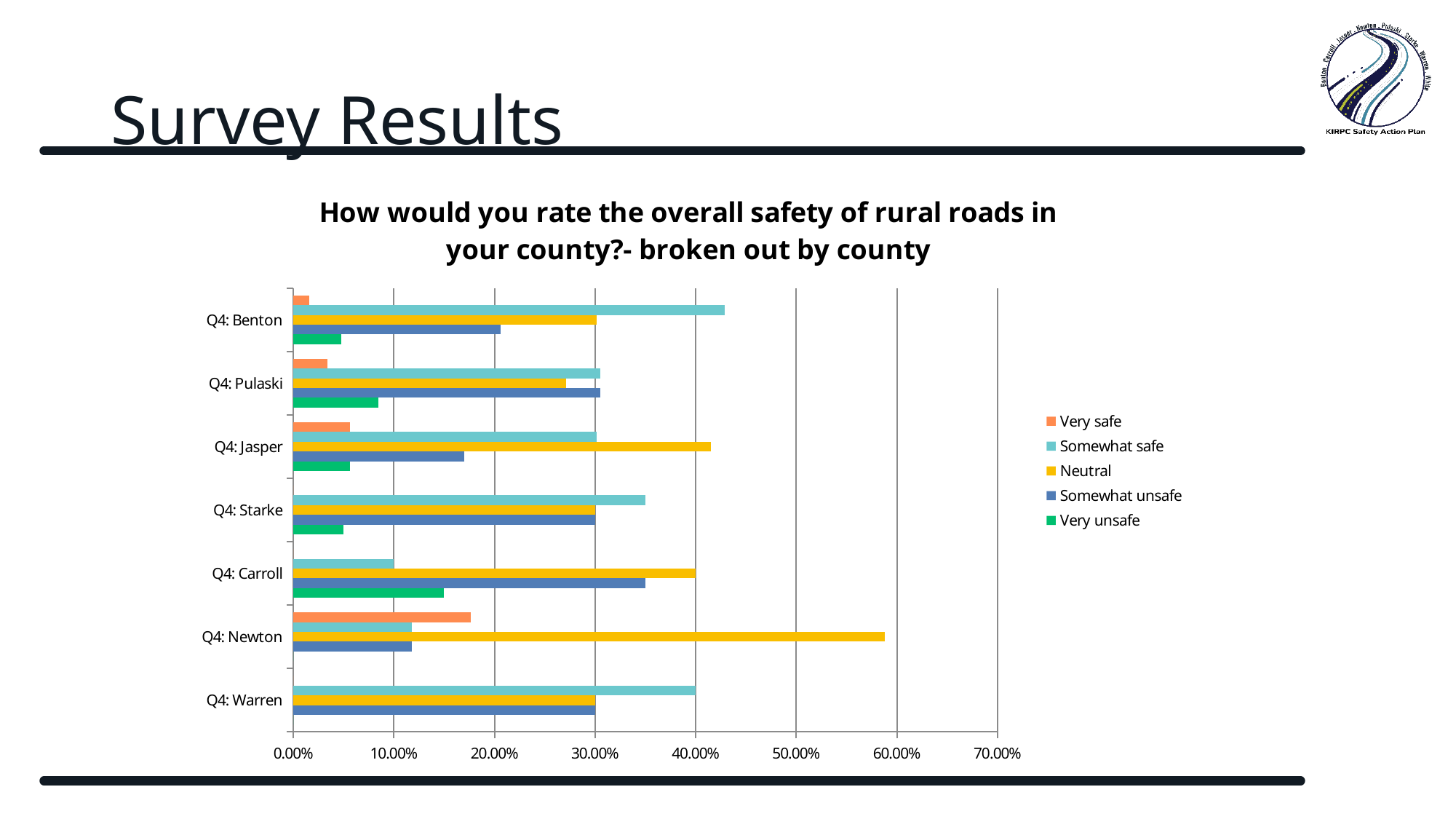
Which county has the highest Very safe value? Q4: Newton What is the title of the chart? How would you rate the overall safety of rural roads in your county?- broken out by county Which is larger, the Somewhat safe value for Q4: Benton or for Q4: Pulaski? Q4: Benton How many series does the legend list? 5 How many counties are shown on the chart? 7 Is the Neutral value for Q4: Newton greater or less than 50.00%? greater Is the Somewhat safe value for Q4: Benton greater or less than 40.00%? greater Which county has the highest Neutral value? Q4: Newton What kind of chart is shown on the slide? bar chart Which is larger for Q4: Jasper, the Neutral value or the Somewhat safe value? Neutral What is the Somewhat safe value for Q4: Warren? 40.00% Is the Somewhat safe value for Q4: Carroll greater or less than 20.00%? less